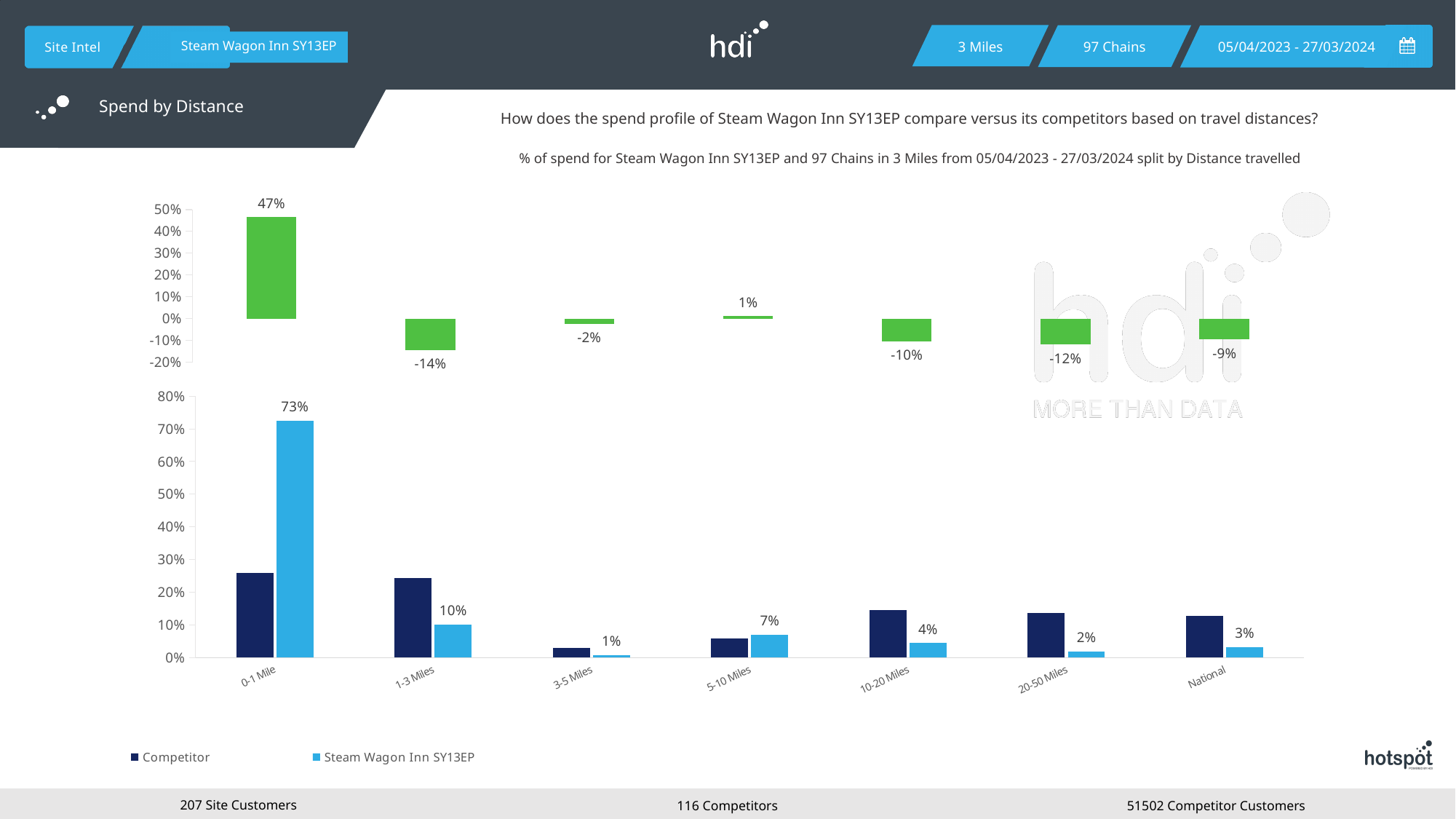
In the bottom chart, which distance band has the highest Steam Wagon Inn SY13EP value? 0-1 Mile In the bottom chart, what is the difference between the Steam Wagon Inn SY13EP values at 0-1 Mile and 1-3 Miles? 63% In the bottom chart, what is the value for Steam Wagon Inn SY13EP at 5-10 Miles? 7% In the bottom chart, is the Competitor value for 3-5 Miles greater or less than 10%? less How many series does the legend of the bottom chart list? 2 In the bottom chart, what is the value for Steam Wagon Inn SY13EP at 0-1 Mile? 73% In the bottom chart, at 10-20 Miles, which is larger: the Competitor bar or the Steam Wagon Inn SY13EP bar? Competitor In the top green chart, what is the value shown on the leftmost bar? 47% In the bottom chart, what is the value for Steam Wagon Inn SY13EP at National? 3% In the bottom chart, which distance band has the lowest Steam Wagon Inn SY13EP value? 3-5 Miles In the bottom chart, is the Competitor value for 0-1 Mile greater or less than 20%? greater How many distance bands are shown on the x axis of the bottom chart? 7